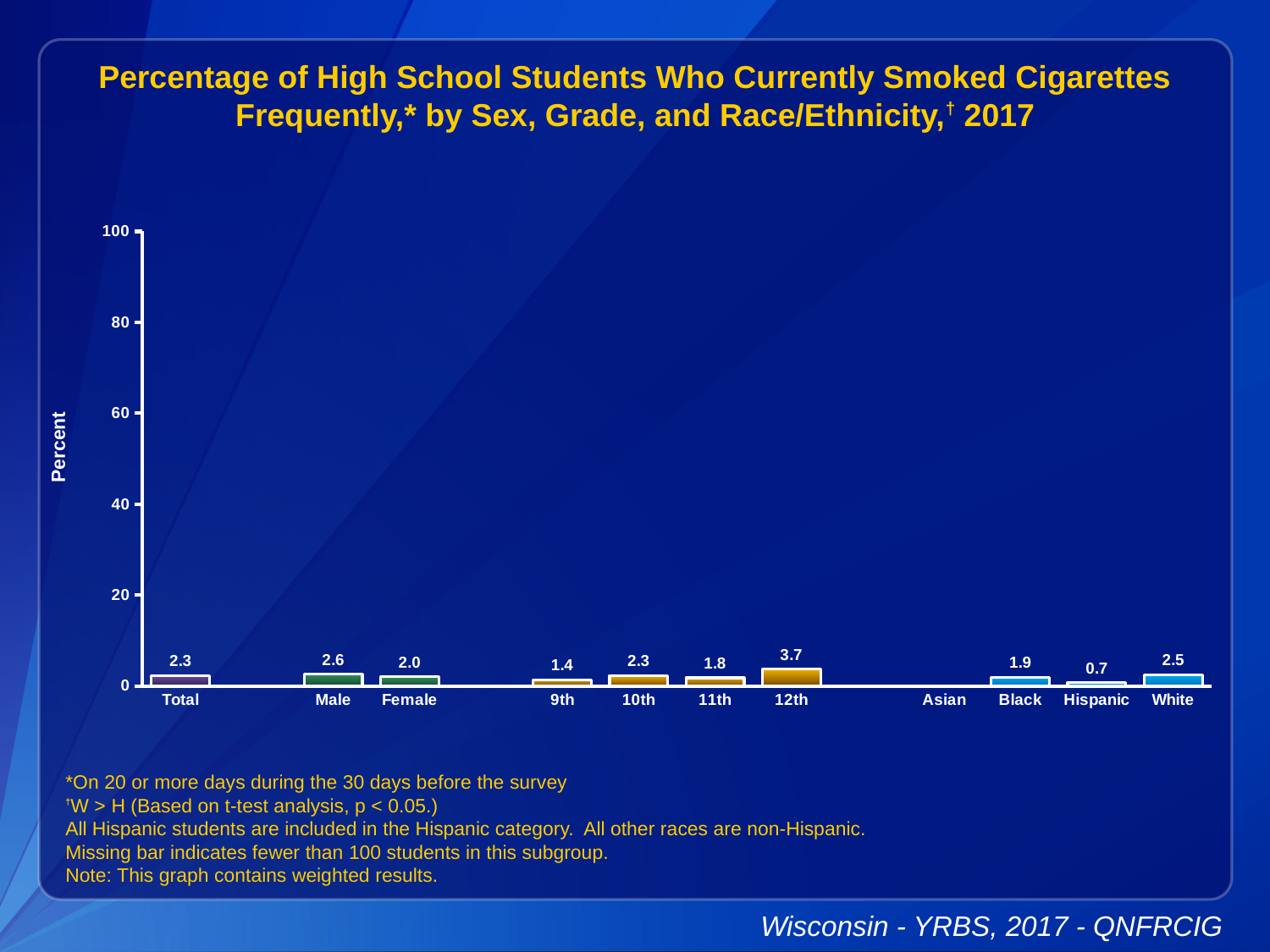
What is the value for Male? 2.6 Which category has the highest value? 12th How many categories are labeled on the x axis? 11 What is the value for 12th grade? 3.7 What is the value for Hispanic? 0.7 What is the difference between the Male and Female values? 0.6 Which is larger, the value for White or the value for Black? White Which category with a bar has the lowest value? Hispanic What kind of chart is this? bar chart Is the value for 12th grade greater or less than 20? less Which category has no bar shown? Asian What is the value for Total? 2.3